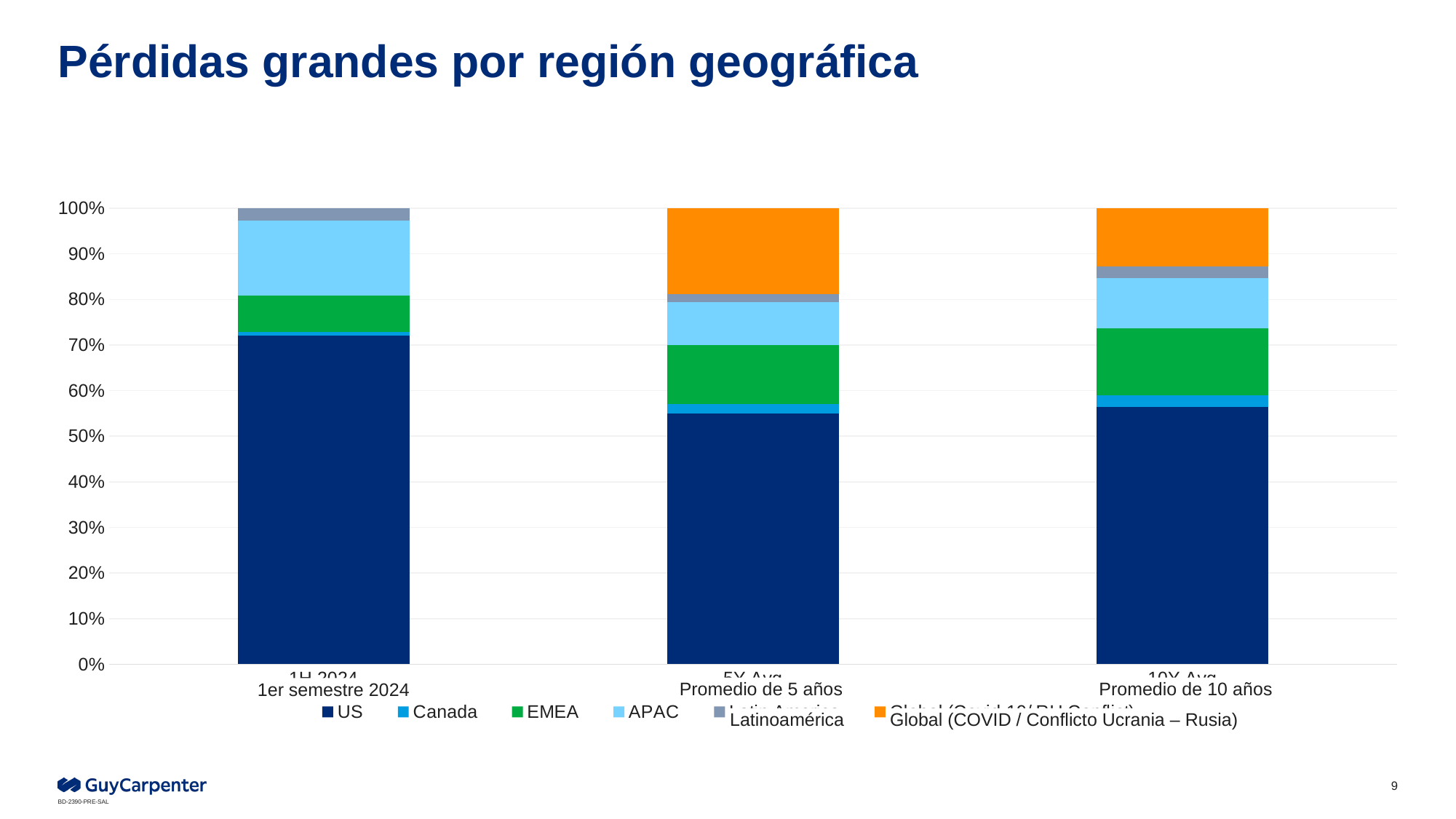
Is the Global (COVID / Conflicto Ucrania – Rusia) segment larger in the Promedio de 5 años bar or the Promedio de 10 años bar? Promedio de 5 años Is the US share in the Promedio de 5 años bar greater or less than 60%? less In which category is the APAC segment the largest? 1er semestre 2024 Which series is shown in orange in the legend? Global (COVID / Conflicto Ucrania – Rusia) What is the total of the stacked bar for Promedio de 10 años? 100% What kind of chart is shown on the slide? Stacked bar chart What is the title of the slide's chart? Pérdidas grandes por región geográfica How many series does the legend list? 6 Is the EMEA segment larger in the 1er semestre 2024 bar or the Promedio de 5 años bar? Promedio de 5 años How many bars (categories) are shown on the x axis? 3 Is the US share in the 1er semestre 2024 bar greater or less than 60%? greater In which category does the US segment take the largest share of the bar? 1er semestre 2024